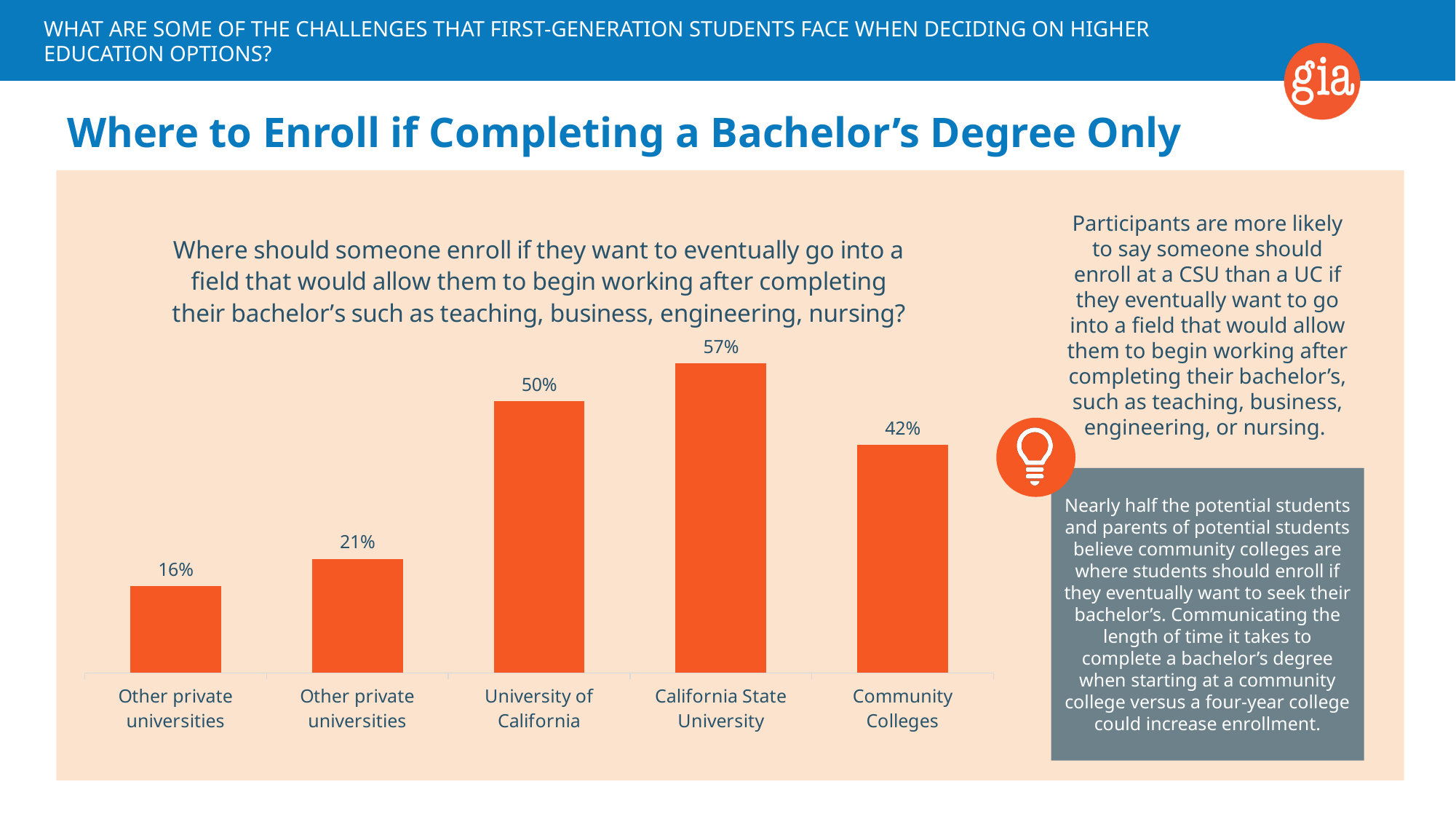
What is the difference between the values for University of California and Community Colleges? 8% What percentage of participants said someone should enroll at California State University? 57% How many bars are shown in the chart? 5 What is the value shown for University of California? 50% What percentage is shown for Community Colleges? 42% What colour are the bars in the chart? Orange What is the difference between the values for California State University and University of California? 7% What type of chart is shown on the slide? Bar chart What is the lowest value shown in the chart? 16% Which category has the highest value in the chart? California State University What is the value of the leftmost bar in the chart? 16% Which is larger, the value for Community Colleges or the value for University of California? University of California